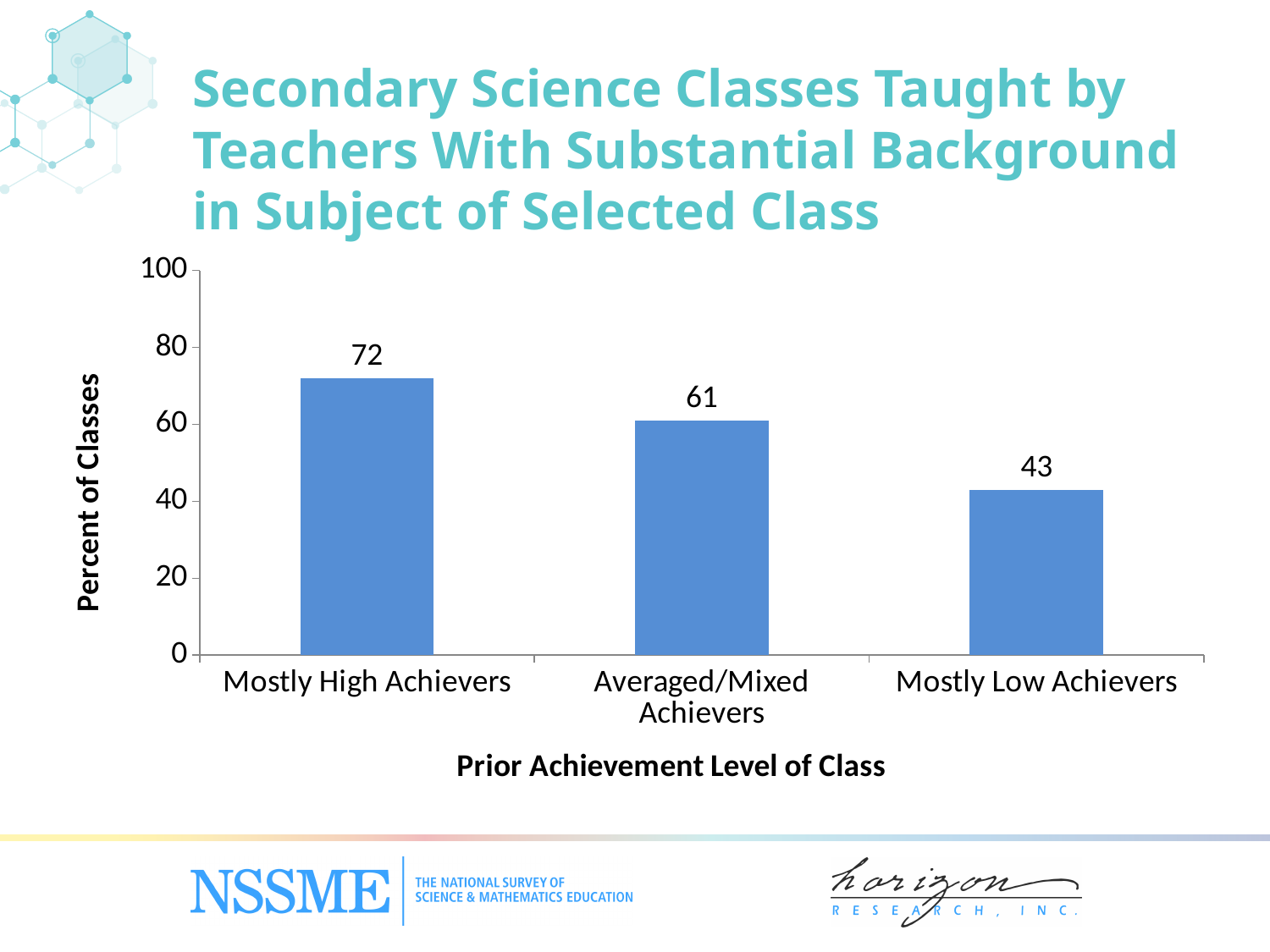
What kind of chart is shown on the slide? bar chart What is the difference between the values for Mostly High Achievers and Mostly Low Achievers? 29 Is the value for Mostly Low Achievers greater or less than 60? less Which prior achievement level has the lowest percent of classes? Mostly Low Achievers What is the value for Mostly Low Achievers? 43 What is the value for Mostly High Achievers? 72 Which prior achievement level has the highest percent of classes? Mostly High Achievers Do the values rise or fall from Mostly High Achievers to Mostly Low Achievers? fall What is the value for Averaged/Mixed Achievers? 61 Which is larger, the value for Averaged/Mixed Achievers or Mostly Low Achievers? Averaged/Mixed Achievers What is the difference between the values for Averaged/Mixed Achievers and Mostly Low Achievers? 18 How many categories are shown on the x axis? 3